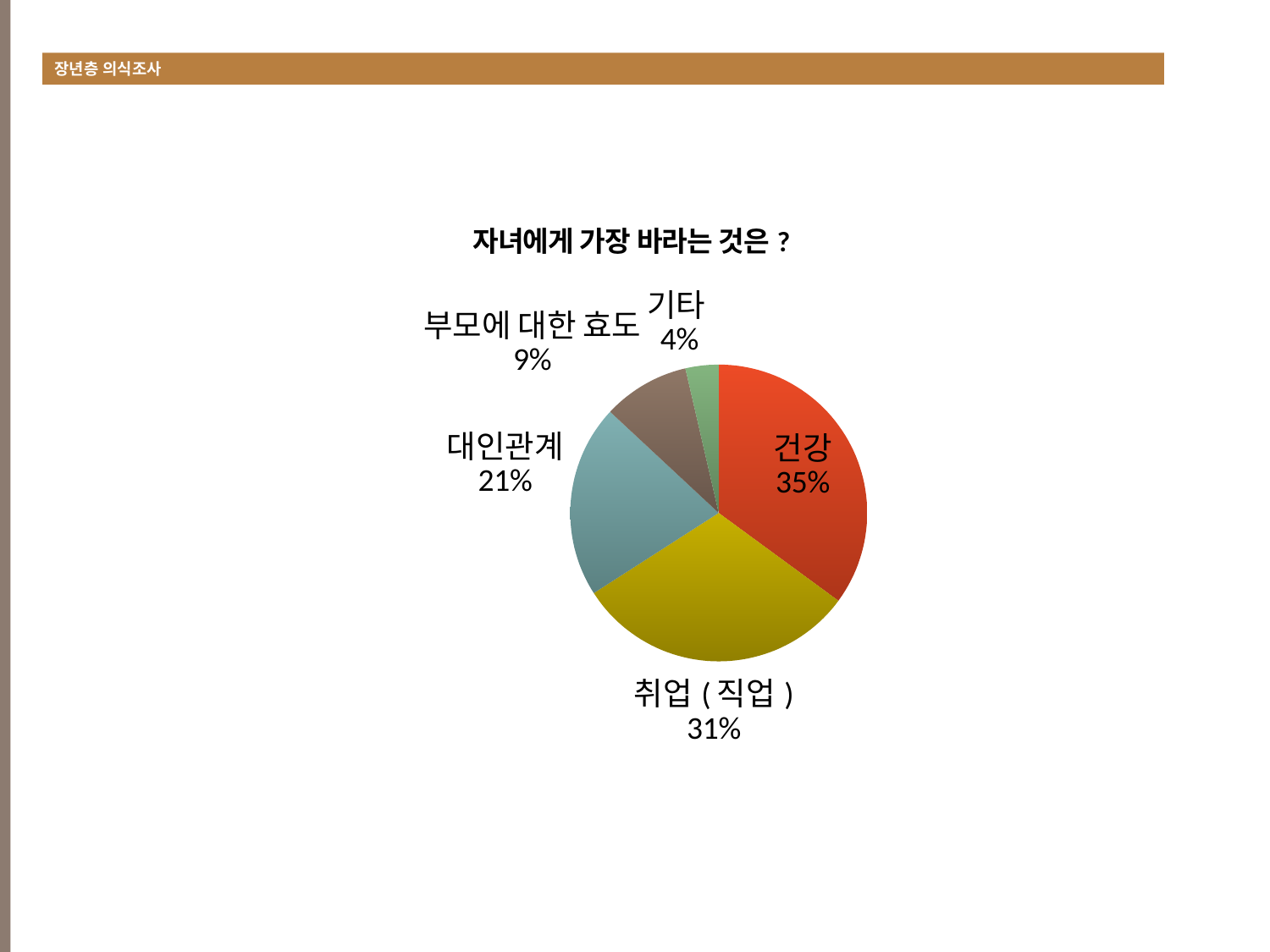
What kind of chart is shown on the slide? pie chart What percentage of the pie is 부모에 대한 효도? 9% What percentage of the pie is 대인관계? 21% What percentage of the pie is 기타? 4% How many categories are shown in the pie chart? 5 What is the difference in percentage points between 건강 and 취업 ( 직업 )? 4 Which category has the largest share of the pie? 건강 Which category has the smallest share of the pie? 기타 What percentage of the pie is 건강? 35% What percentage of the pie is 취업 ( 직업 )? 31% What is the title of the chart? 자녀에게 가장 바라는 것은 ? Which is larger, the share for 대인관계 or the share for 부모에 대한 효도? 대인관계